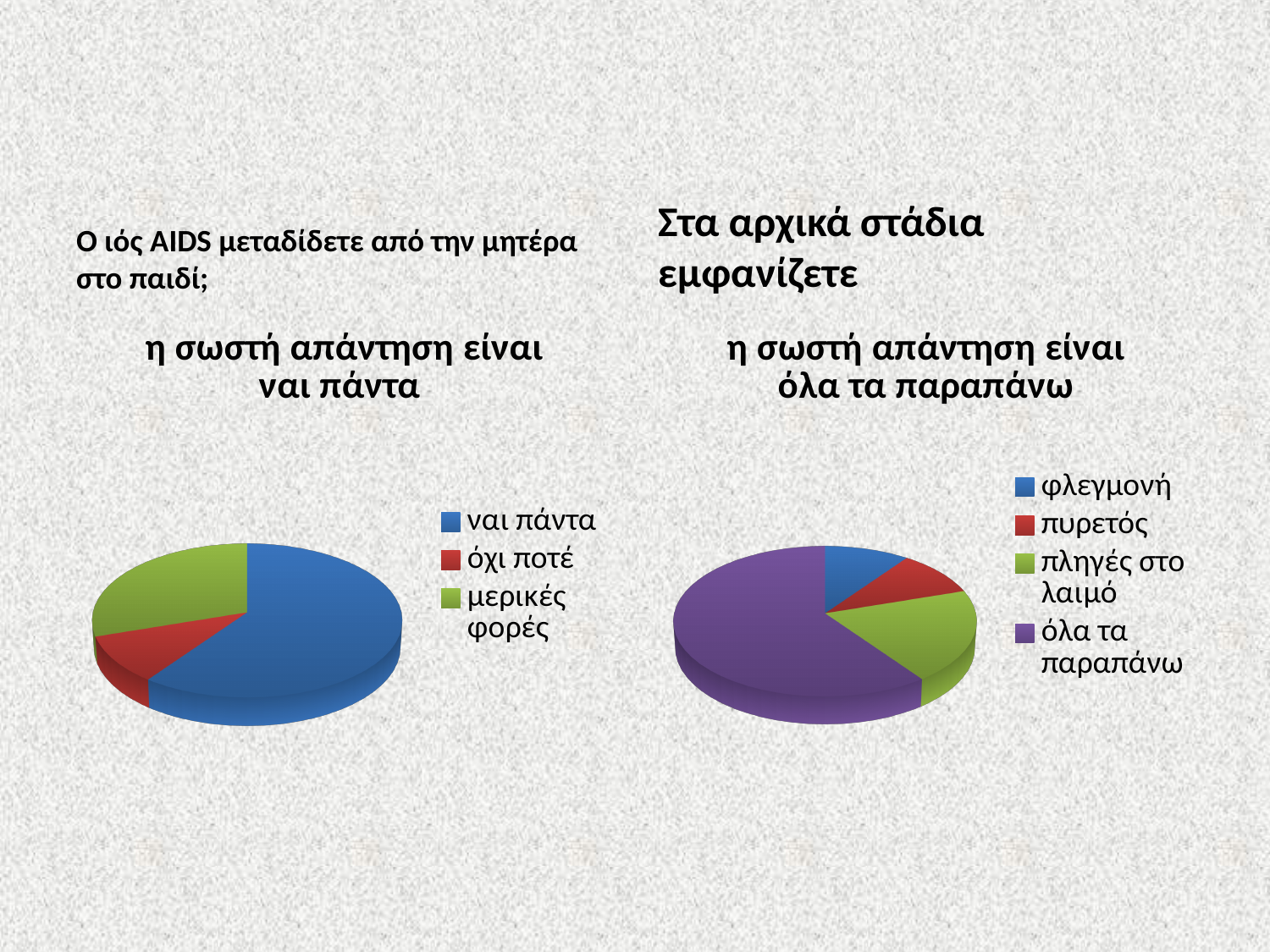
In the right pie chart, what colour is the slice for όλα τα παραπάνω? purple How many slices does the left pie chart have? 3 How many slices does the right pie chart have? 4 What kind of chart is the right chart (Στα αρχικά στάδια εμφανίζετε)? pie chart In the left pie chart, what colour is the slice for μερικές φορές? green What kind of chart is the left chart (Ο ιός AIDS μεταδίδετε από την μητέρα στο παιδί;)? pie chart In the right pie chart, which slice is larger: όλα τα παραπάνω or πληγές στο λαιμό? όλα τα παραπάνω In the right pie chart, which slice is larger: πληγές στο λαιμό or πυρετός? πληγές στο λαιμό In the right pie chart, which category has the largest slice? όλα τα παραπάνω In the left pie chart, which category has the smallest slice? όχι ποτέ In the left pie chart, which category has the largest slice? ναι πάντα In the left pie chart, which slice is larger: ναι πάντα or μερικές φορές? ναι πάντα